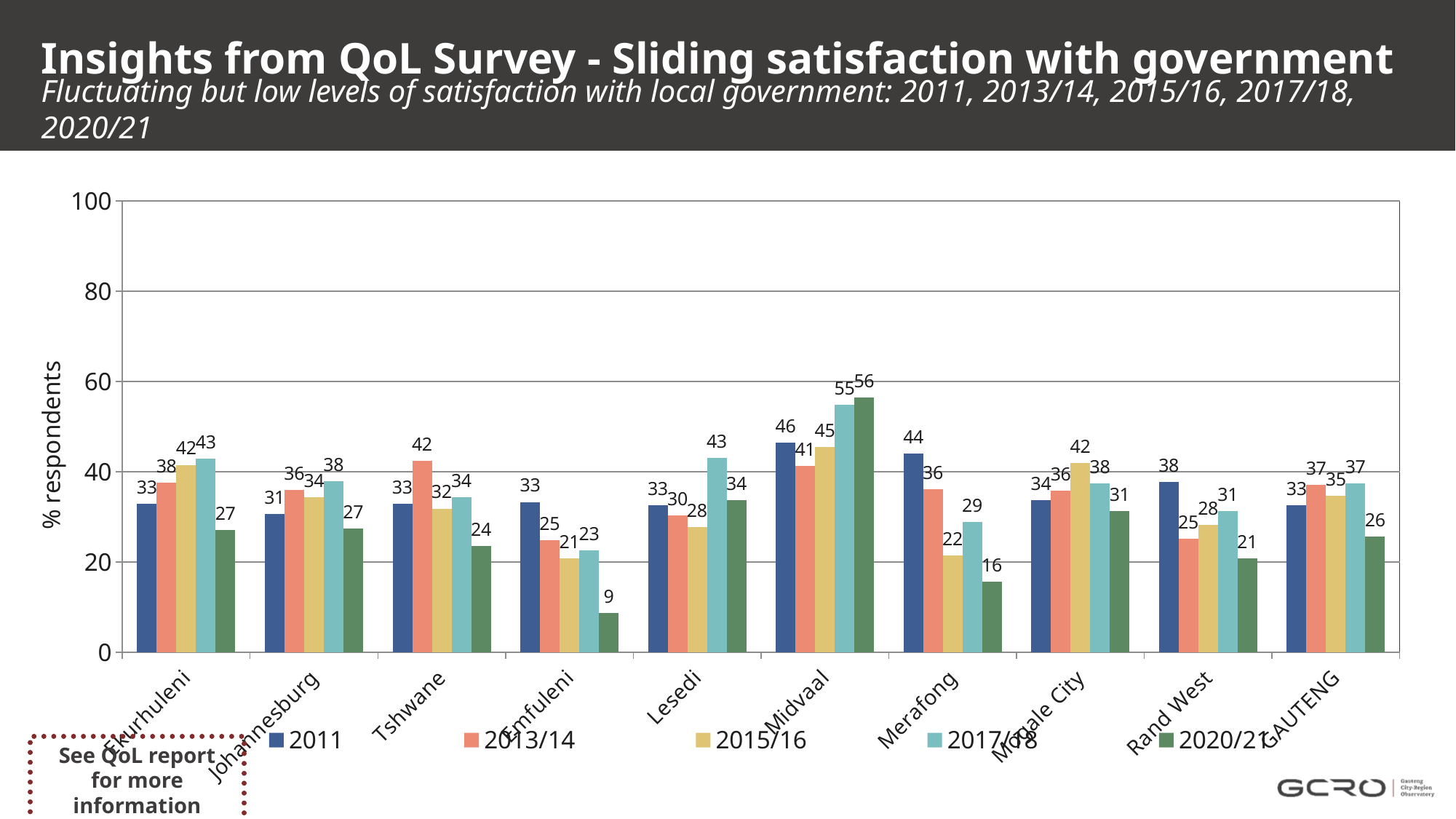
What is the 2020/21 value for Emfuleni? 9 What kind of chart is shown on the slide? bar chart Which is larger for Mogale City: the 2015/16 value or the 2017/18 value? 2015/16 How many series does the legend list? 5 Is the 2017/18 value for Midvaal greater or less than 40? greater Which municipality has the lowest 2020/21 value? Emfuleni Which municipality has the highest 2020/21 value? Midvaal What is the 2013/14 value for Tshwane? 42 What is the difference between the 2011 and 2020/21 values for Merafong? 28 What is the 2017/18 value for Lesedi? 43 What is the label on the y axis? % respondents How many municipalities/categories are shown on the x axis? 10